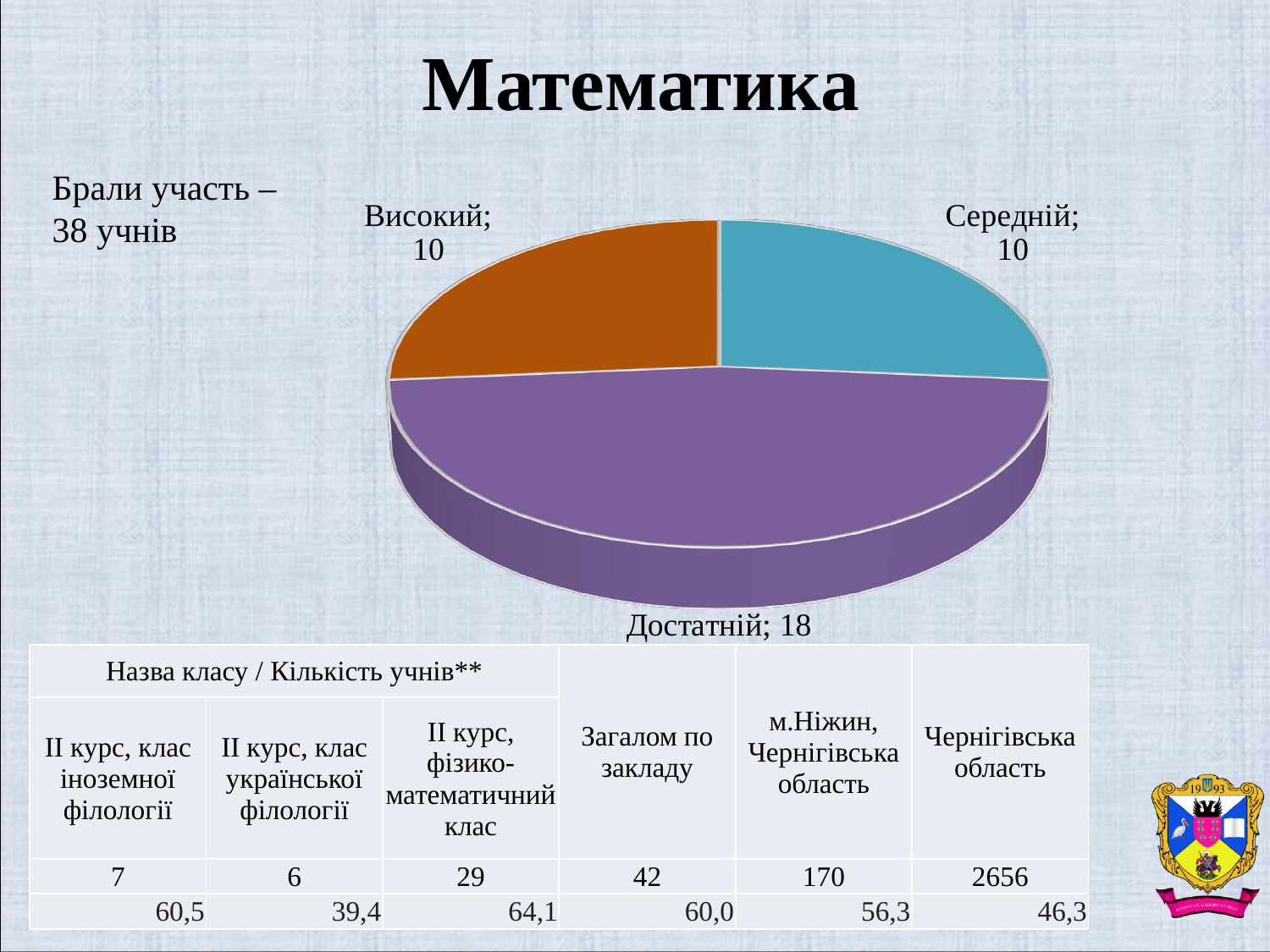
What is the total of all the slice values in the pie chart? 38 What is the title of the slide containing the pie chart? Математика What is the value for the Середній slice of the pie chart? 10 What share of the pie does the Достатній slice represent? 47.4% What is the value for the Високий slice of the pie chart? 10 How many slices does the pie chart have? 3 What colour is the Достатній slice in the pie chart? purple Which is larger, the value for Достатній or the value for Середній? Достатній What kind of chart is shown on the slide? pie chart What is the value for the Достатній slice of the pie chart? 18 What is the difference between the values for Достатній and Високий? 8 Which category has the largest slice in the pie chart? Достатній